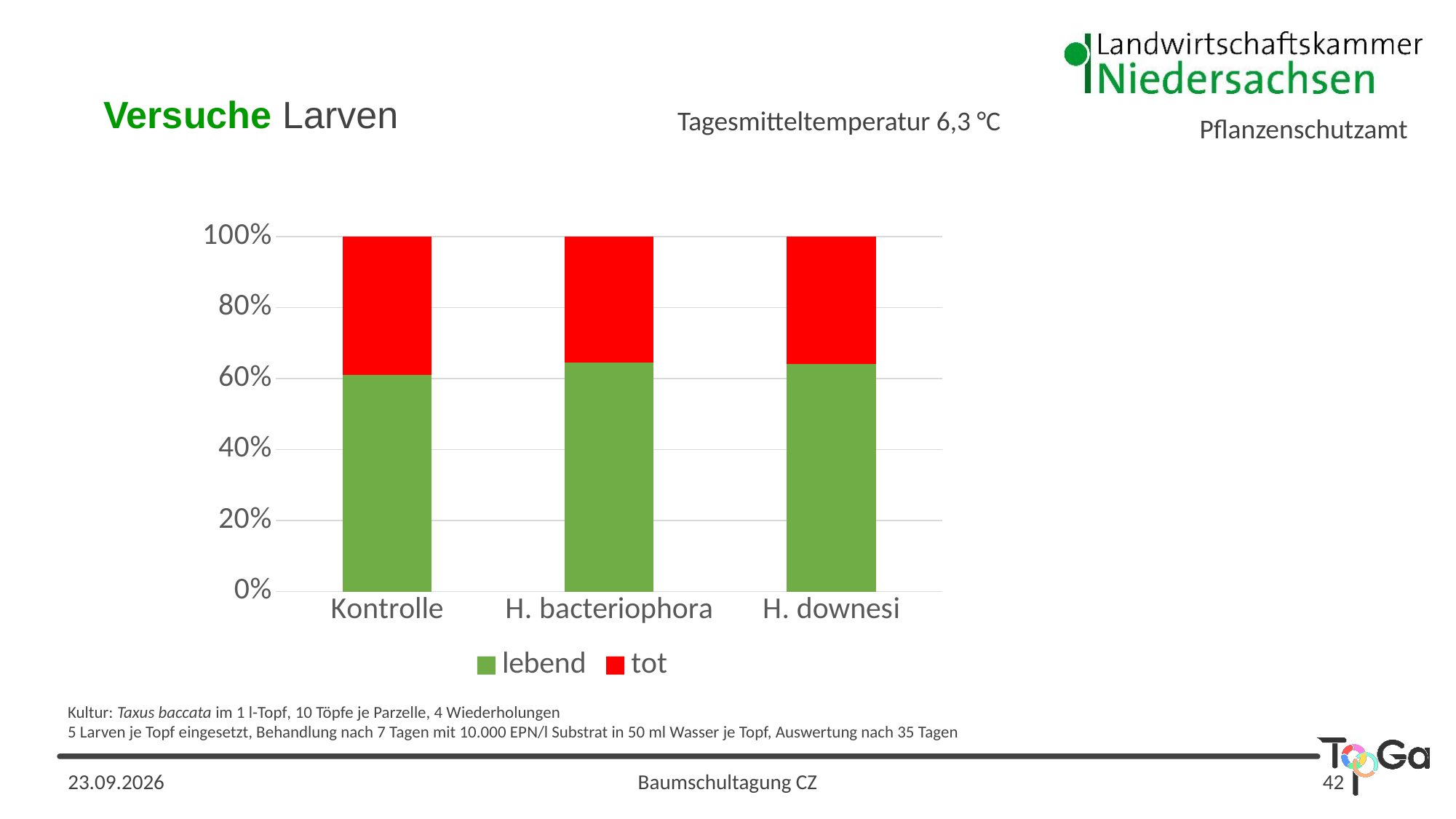
Is the 'tot' share for H. downesi greater or less than 60%? less Is the 'lebend' value for H. downesi greater or less than 80%? less What is the total height of the stacked bar for Kontrolle? 100% How many categories are shown on the x axis of the chart? 3 Is the 'lebend' value for Kontrolle greater or less than 80%? less How many series does the chart legend list? 2 Which category has the highest 'tot' share? Kontrolle Which colour represents the series 'tot' in the chart? red Which category has the lowest 'lebend' share? Kontrolle What kind of chart is shown on the slide? bar chart What are the two series listed in the chart legend? lebend, tot